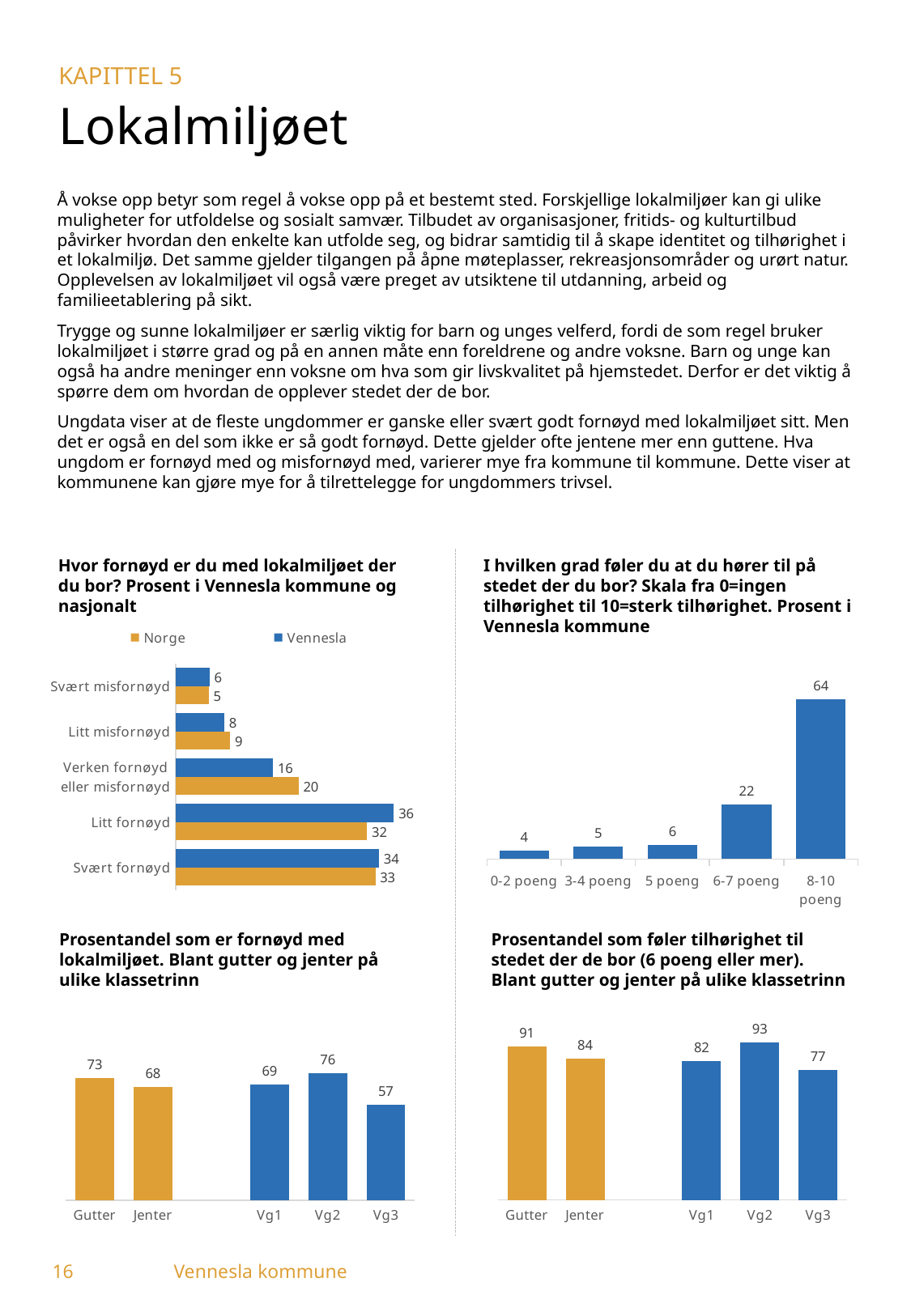
In the top-right chart 'I hvilken grad føler du at du hører til på stedet der du bor?', how many categories are shown on the x axis? 5 What kind of chart is the bottom-right chart 'Prosentandel som føler tilhørighet til stedet der de bor'? bar chart In the top-right chart 'I hvilken grad føler du at du hører til på stedet der du bor?', which category has the highest value? 8-10 poeng In the bottom-left chart 'Prosentandel som er fornøyd med lokalmiljøet', what is the difference between Gutter and Jenter? 5 In the top-left chart 'Hvor fornøyd er du med lokalmiljøet der du bor?', what is the value for Norge in the 'Verken fornøyd eller misfornøyd' category? 20 In the top-left chart 'Hvor fornøyd er du med lokalmiljøet der du bor?', what is the value for Vennesla in the 'Litt fornøyd' category? 36 In the top-right chart 'I hvilken grad føler du at du hører til på stedet der du bor?', what is the value for '6-7 poeng'? 22 In the bottom-right chart 'Prosentandel som føler tilhørighet til stedet der de bor', which is larger, Vg1 or Vg2? Vg2 In the top-left chart 'Hvor fornøyd er du med lokalmiljøet der du bor?', how many series does the legend list? 2 In the bottom-left chart 'Prosentandel som er fornøyd med lokalmiljøet', which category has the lowest value? Vg3 In the top-left chart 'Hvor fornøyd er du med lokalmiljøet der du bor?', what is the difference between Vennesla and Norge for 'Svært misfornøyd'? 1 In the top-right chart 'I hvilken grad føler du at du hører til på stedet der du bor?', do the values rise or fall from left to right along the x axis? rise